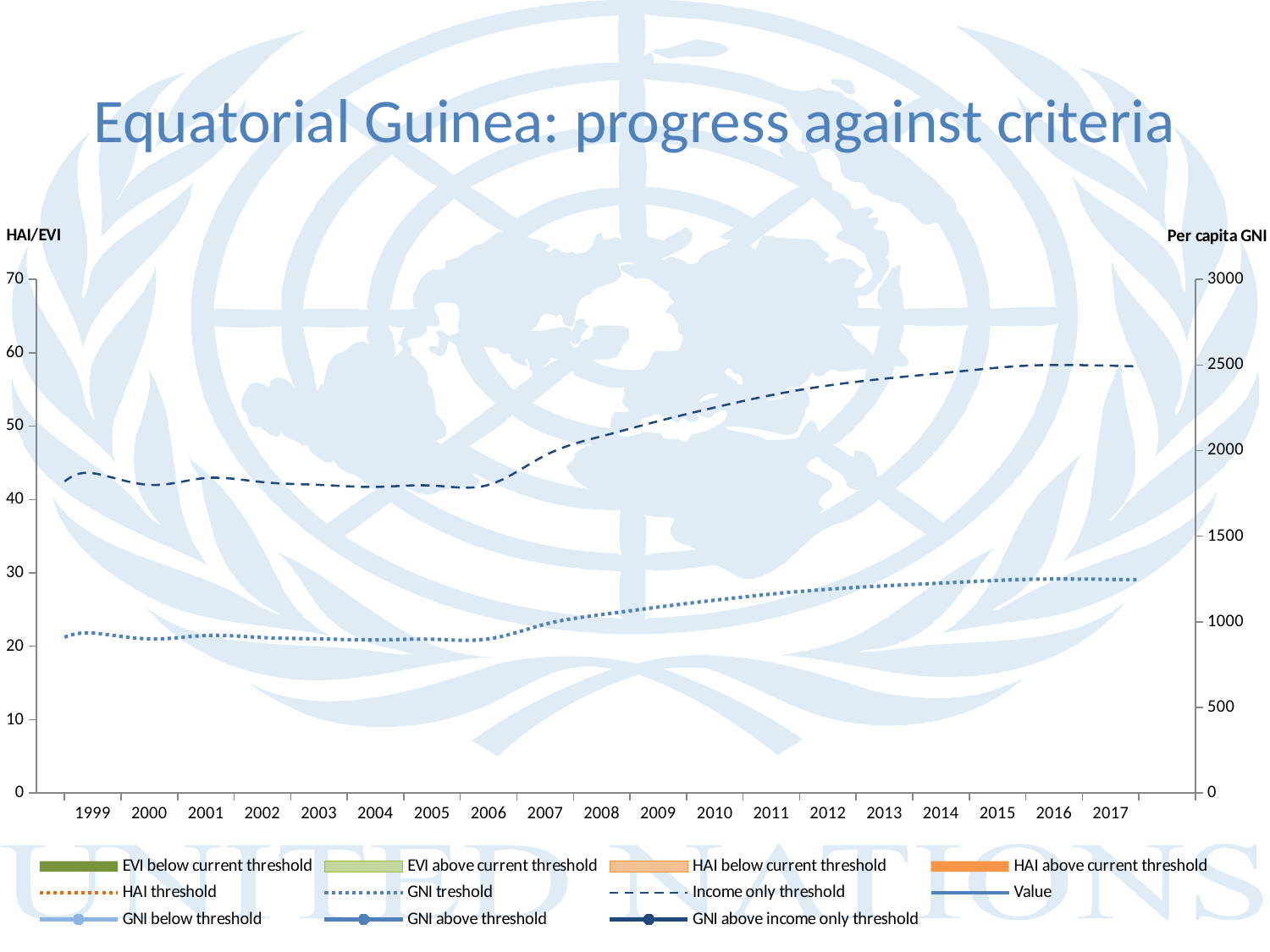
What is the label of the right-hand vertical axis? Per capita GNI What kind of chart is shown on the slide? line chart Read against the right-hand Per capita GNI axis, is the dotted 'GNI treshold' line in 2017 greater or less than 1500? less Read against the right-hand Per capita GNI axis, is the dashed 'Income only threshold' line in 1999 greater or less than 2000? less What is the title of the chart on the slide? Equatorial Guinea: progress against criteria Read against the right-hand Per capita GNI axis, is the dashed 'Income only threshold' line in 2017 greater or less than 2000? greater Does the dashed 'Income only threshold' line rise or fall between 2006 and 2017? rise In 2017, which line is higher on the chart: the dashed 'Income only threshold' line or the dotted 'GNI treshold' line? Income only threshold How many years are labelled along the x axis of the chart? 19 Does the dotted 'GNI treshold' line rise or fall between 2006 and 2017? rise How many entries does the chart's legend list? 11